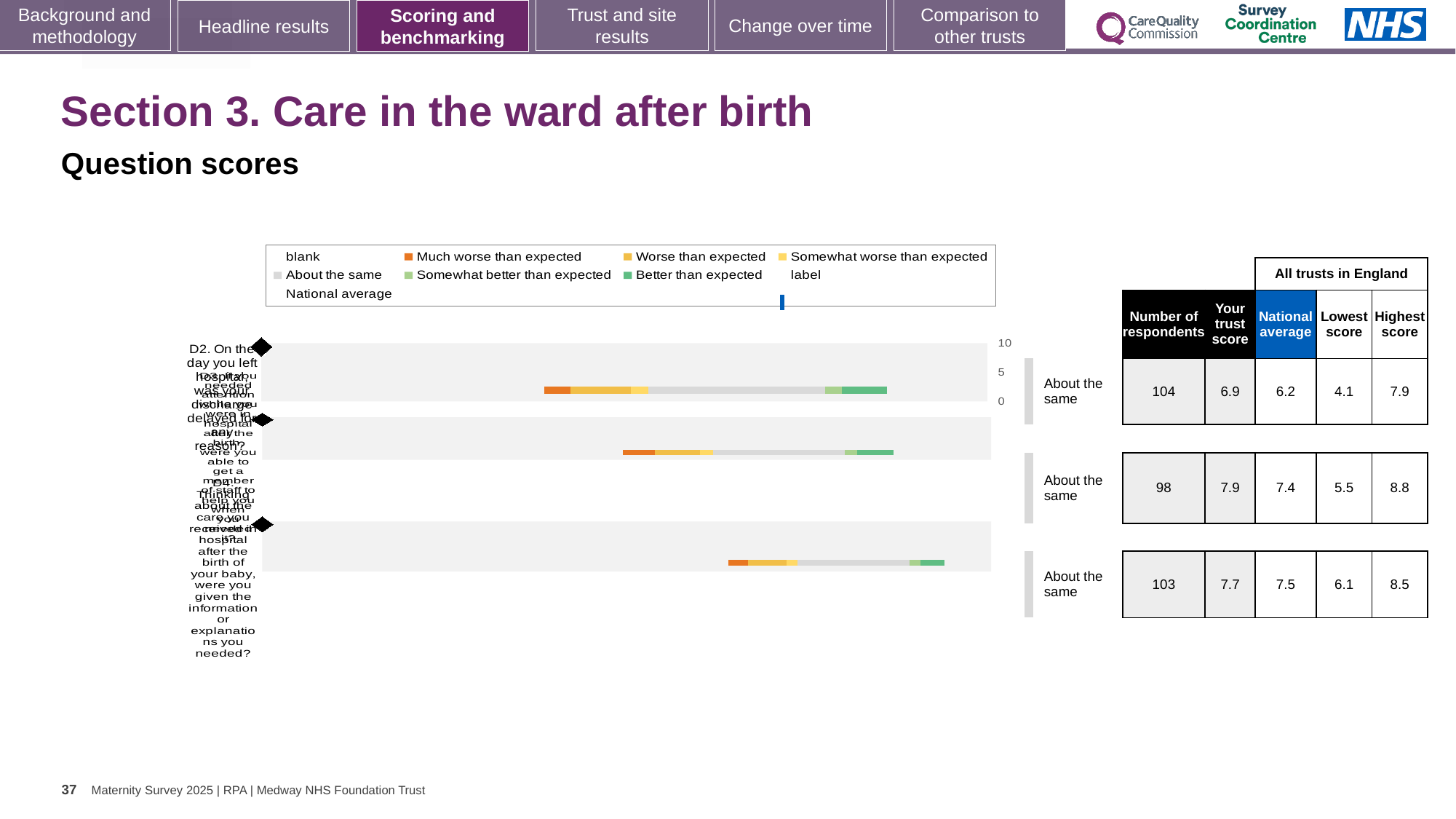
In the table, what is the number of respondents for the first (top) question row? 104 In the table, what is the 'Your trust score' for the second (middle) question row? 7.9 For the third (bottom) question row, which is larger: 'Your trust score' or the national average? Your trust score Which question row has the highest 'Your trust score' in the table? the second (middle) row What benchmark category is shown for all three question rows? About the same What is the difference between 'Your trust score' and the national average for the first (top) question row? 0.7 How many question rows (bars) are plotted in the chart? 3 In the table, what is the national average for the third (bottom) question row? 7.5 What kind of chart is shown on the slide? bar chart In the table, what is the highest score among all trusts in England for the second (middle) question row? 8.8 Which question row has the lowest number of respondents in the table? the second (middle) row What colour does the legend use for 'Much worse than expected'? orange